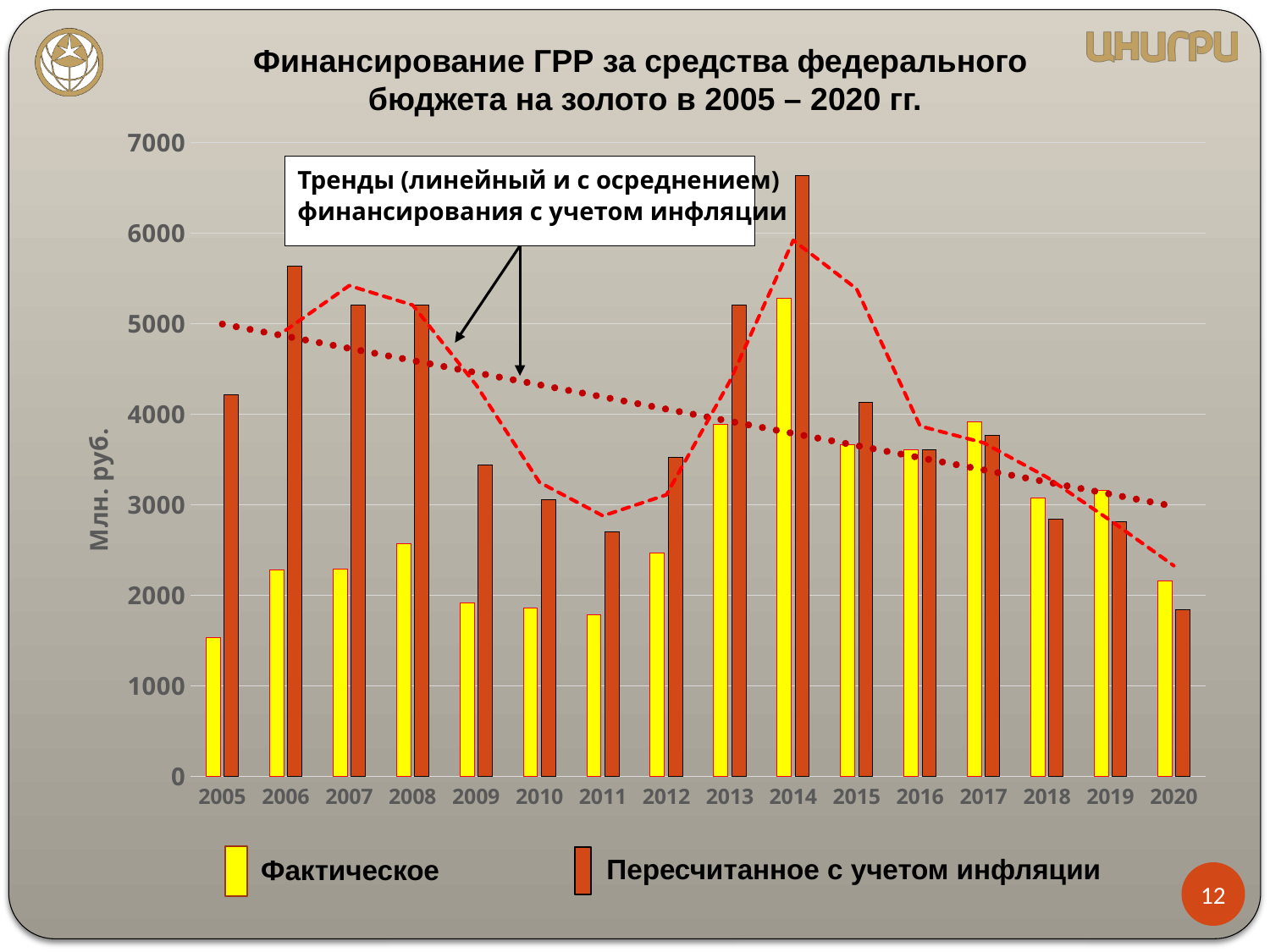
In which year is the Пересчитанное с учетом инфляции value highest? 2014 In which year is the Пересчитанное с учетом инфляции value lowest? 2020 Is the Пересчитанное с учетом инфляции value for 2014 greater or less than 6000? greater What kind of chart is shown on the slide? Bar chart Which is larger: the Пересчитанное с учетом инфляции value for 2006 or for 2007? 2006 How many years are shown on the x axis? 16 Does the Фактическое value rise or fall from 2011 to 2014? rise Is the Пересчитанное с учетом инфляции value for 2011 greater or less than 3000? less Is the Фактическое value for 2005 greater or less than 2000? less How many series does the legend list? 2 In which year is the Фактическое value lowest? 2005 In which year is the Фактическое value highest? 2014